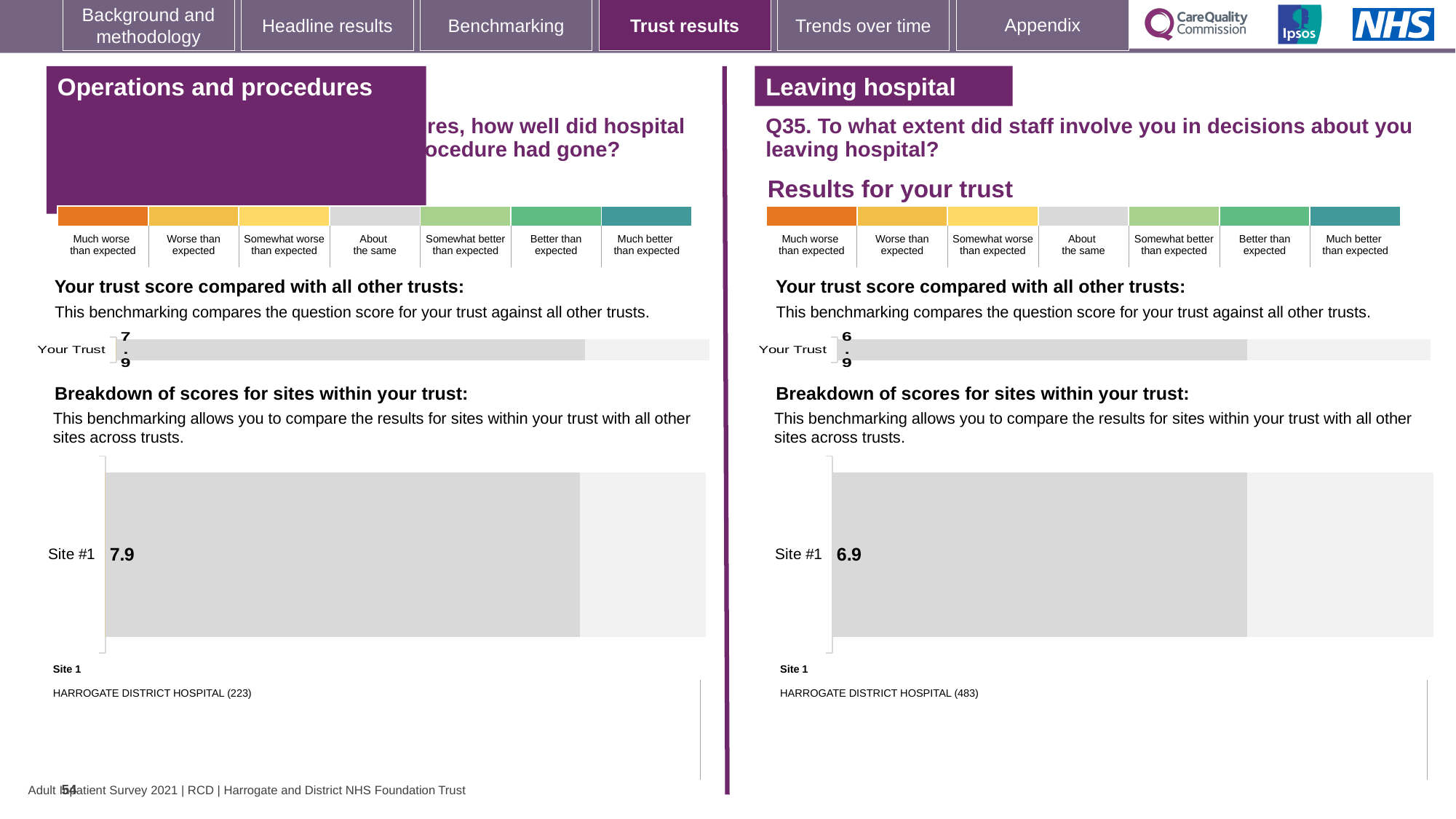
Which site is listed as Site 1 in the right 'Leaving hospital' section, and how many respondents are shown in brackets? HARROGATE DISTRICT HOSPITAL (483) Which is larger: the Your Trust score in the left 'Operations and procedures' chart or the Your Trust score in the right 'Leaving hospital' chart? Operations and procedures (7.9) How many sites are plotted in the right 'Breakdown of scores for sites within your trust' chart? 1 How many sites are plotted in the left 'Breakdown of scores for sites within your trust' chart? 1 Is the Site #1 score in the right 'Leaving hospital' breakdown chart greater or less than the Site #1 score in the left 'Operations and procedures' breakdown chart? less What type of chart is used to show the Your Trust score in the 'Your trust score compared with all other trusts' sections? Bar chart On the right 'Leaving hospital' section (Q35), what is the score shown for Your Trust in the 'Your trust score compared with all other trusts' chart? 6.9 Which site is listed as Site 1 in the left 'Operations and procedures' section, and how many respondents are shown in brackets? HARROGATE DISTRICT HOSPITAL (223) In the left 'Breakdown of scores for sites within your trust' chart, what is the score for Site #1? 7.9 What is the difference between the Site #1 score in the left breakdown chart and the Site #1 score in the right breakdown chart? 1.0 On the left 'Operations and procedures' section, what is the score shown for Your Trust in the 'Your trust score compared with all other trusts' chart? 7.9 In the right 'Breakdown of scores for sites within your trust' chart under Q35, what is the score for Site #1? 6.9